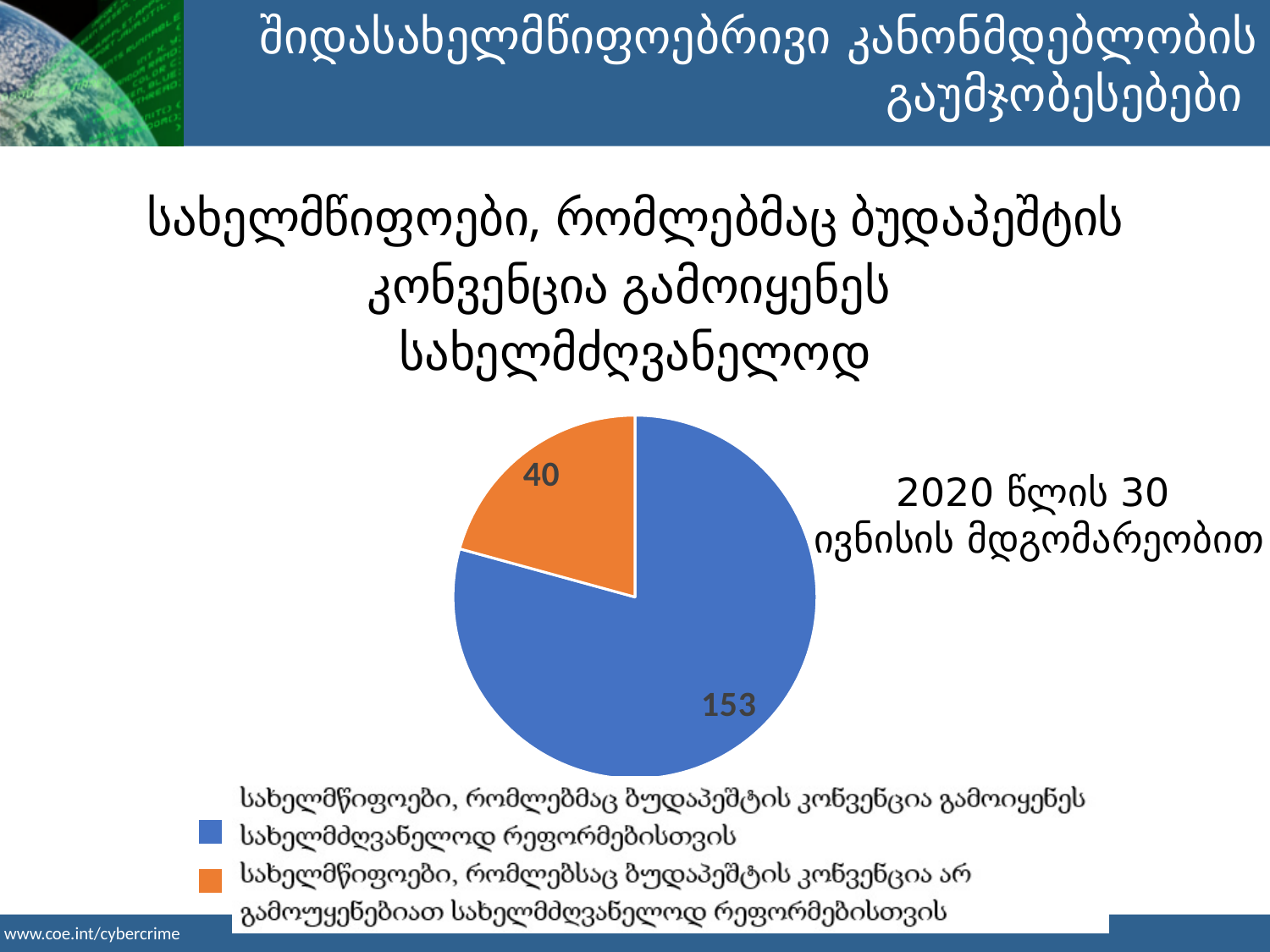
What is the difference between the blue slice value and the orange slice value? 113 How many slices does the pie chart have? 2 What is the value of the orange slice (სახელმწიფოები, რომლებსაც ბუდაპეშტის კონვენცია არ გამოუყენებიათ სახელმძღვანელოდ რეფორმებისთვის)? 40 What is the value of the blue slice (სახელმწიფოები, რომლებმაც ბუდაპეშტის კონვენცია გამოიყენეს სახელმძღვანელოდ რეფორმებისთვის)? 153 Which slice of the pie chart is the smallest? the orange slice (40) Which slice of the pie chart is the largest? the blue slice (153) Which is larger: the value for states that used the Budapest Convention as a guideline (blue) or the value for states that did not (orange)? blue (153) How many entries does the legend of the pie chart list? 2 What is the total of the two slice values in the pie chart? 193 What kind of chart is shown on the slide? pie chart Which colour represents states that used the Budapest Convention as a guideline for reforms? blue